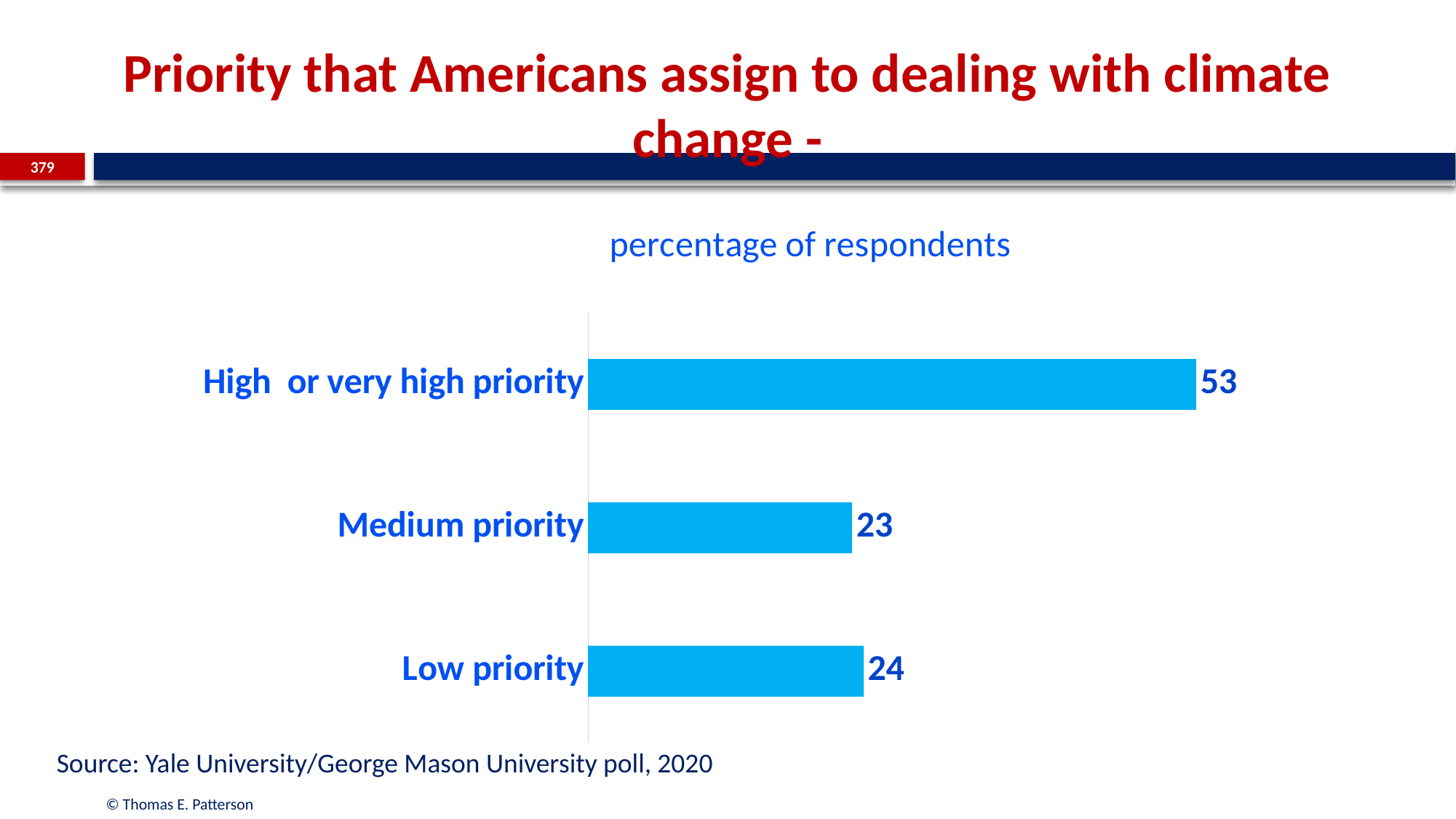
What is the difference between the High or very high priority value and the Low priority value? 29 Which is larger, the value for High or very high priority or the value for Medium priority? High or very high priority What is the difference between the Low priority value and the Medium priority value? 1 What percentage of respondents assign high or very high priority to dealing with climate change? 53 What is the value for Low priority? 24 What is the value for Medium priority? 23 What is the subtitle shown above the chart? percentage of respondents What is the total of the three values shown in the chart? 100 Which category has the highest value? High or very high priority How many categories are shown in the chart? 3 Which category has the lowest value? Medium priority What kind of chart is shown on the slide? Bar chart